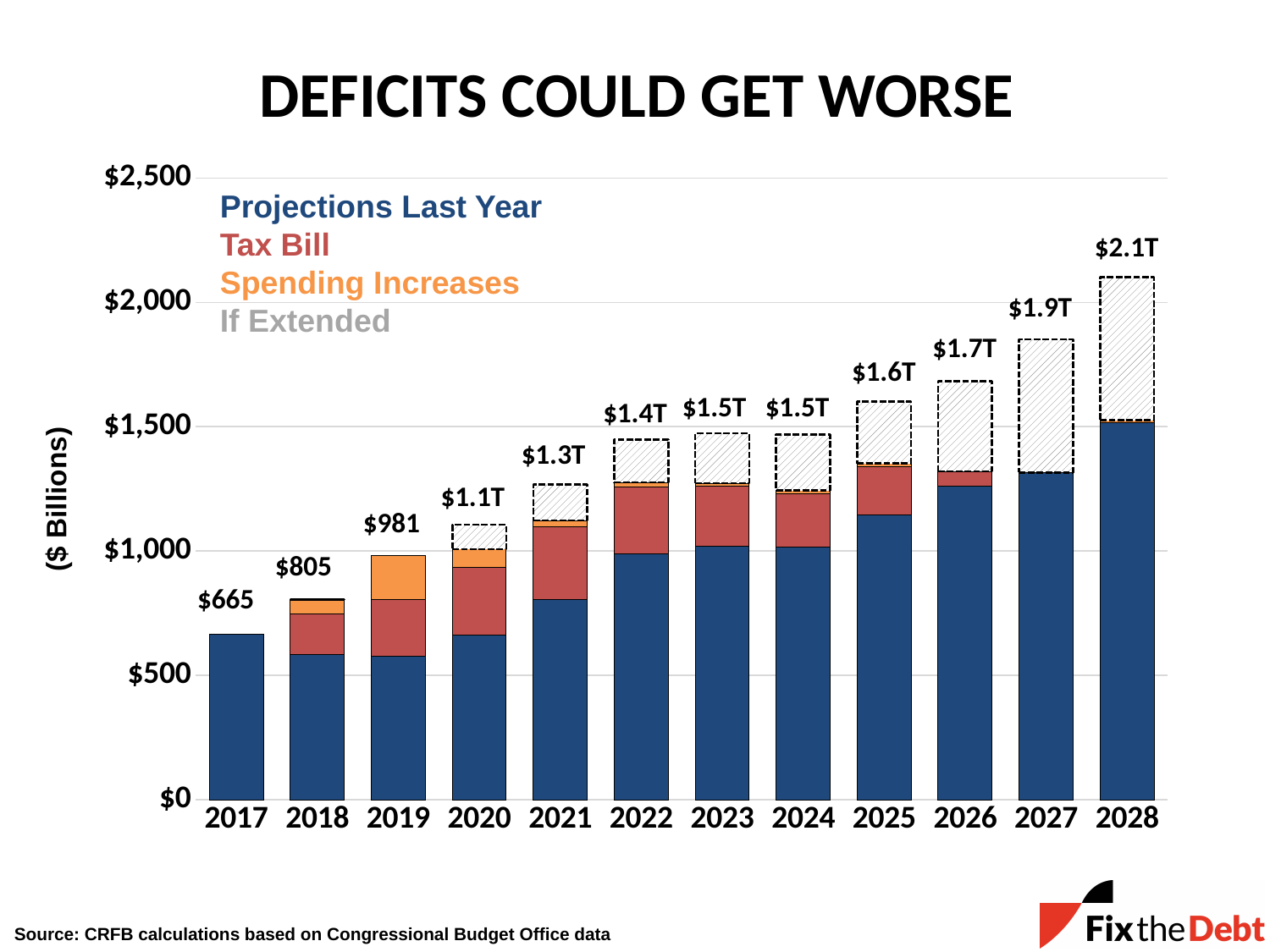
Is the value of the Projections Last Year segment for 2017 greater or less than $1,000? less What is the total deficit labeled above the bar for 2024? $1.5T What is the total deficit labeled above the bar for 2019? $981 What is the difference between the labeled totals for 2018 and 2017? $140 How many years are shown on the x axis? 12 How many series does the legend list? 4 Which year has a larger labeled total deficit, 2019 or 2018? 2019 Which year has the lowest labeled total deficit? 2017 What is the total deficit labeled above the bar for 2028? $2.1T What is the total deficit labeled above the bar for 2017? $665 Do the labeled total deficits generally rise or fall from 2017 to 2028? rise Which year has the highest labeled total deficit? 2028